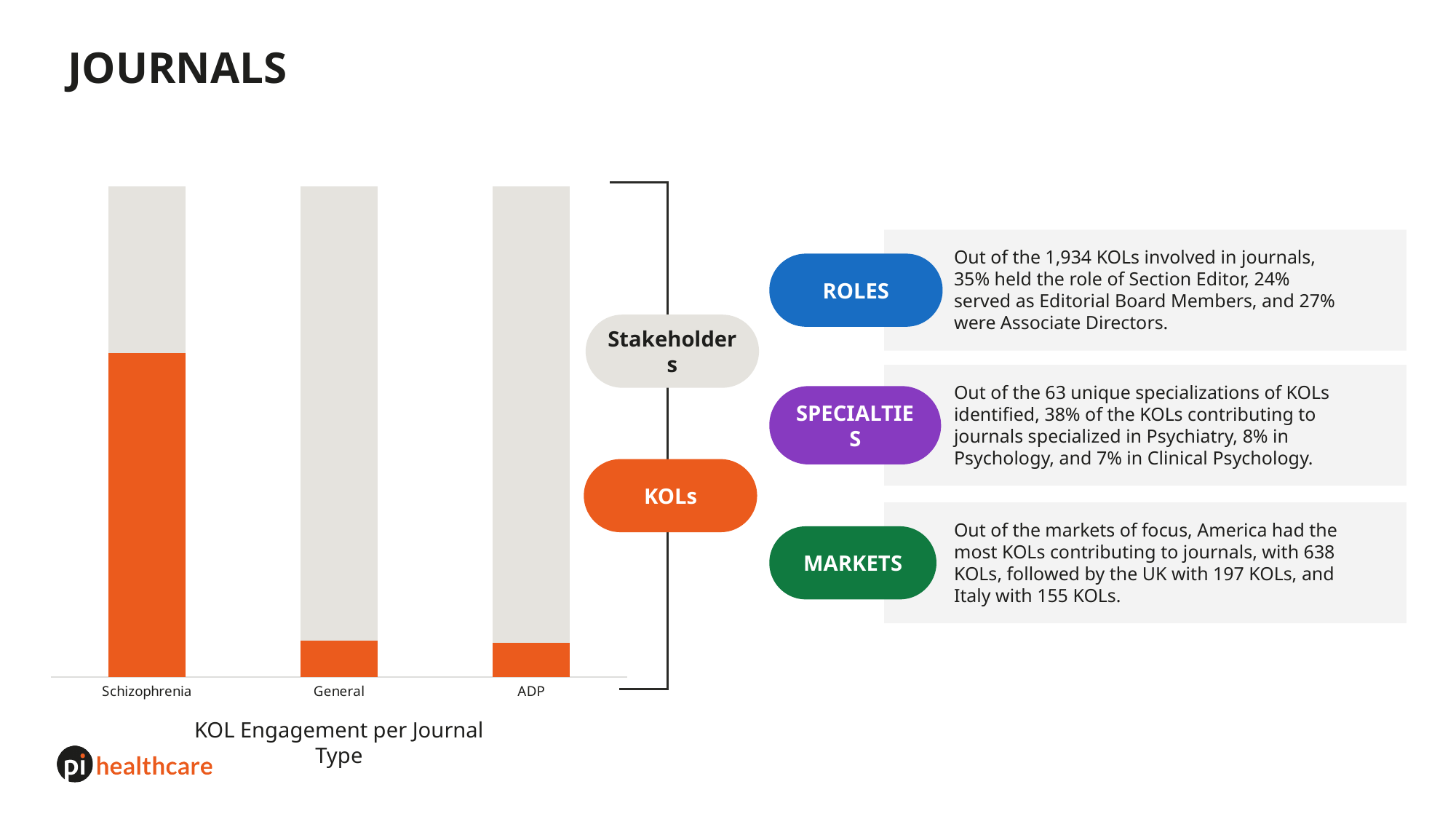
What kind of chart is shown on the slide? Stacked bar chart Which colour represents the KOLs series in the chart? Orange How many journal types are shown on the x axis of the chart? 3 Is the Stakeholders portion larger for General or for Schizophrenia? General Which journal type has the smallest Stakeholders portion in the chart? Schizophrenia What is the title of the chart? KOL Engagement per Journal Type Is the KOLs portion larger for ADP or for Schizophrenia? Schizophrenia Is the KOLs portion larger for Schizophrenia or for General? Schizophrenia Which journal type has the largest KOLs portion in the chart? Schizophrenia